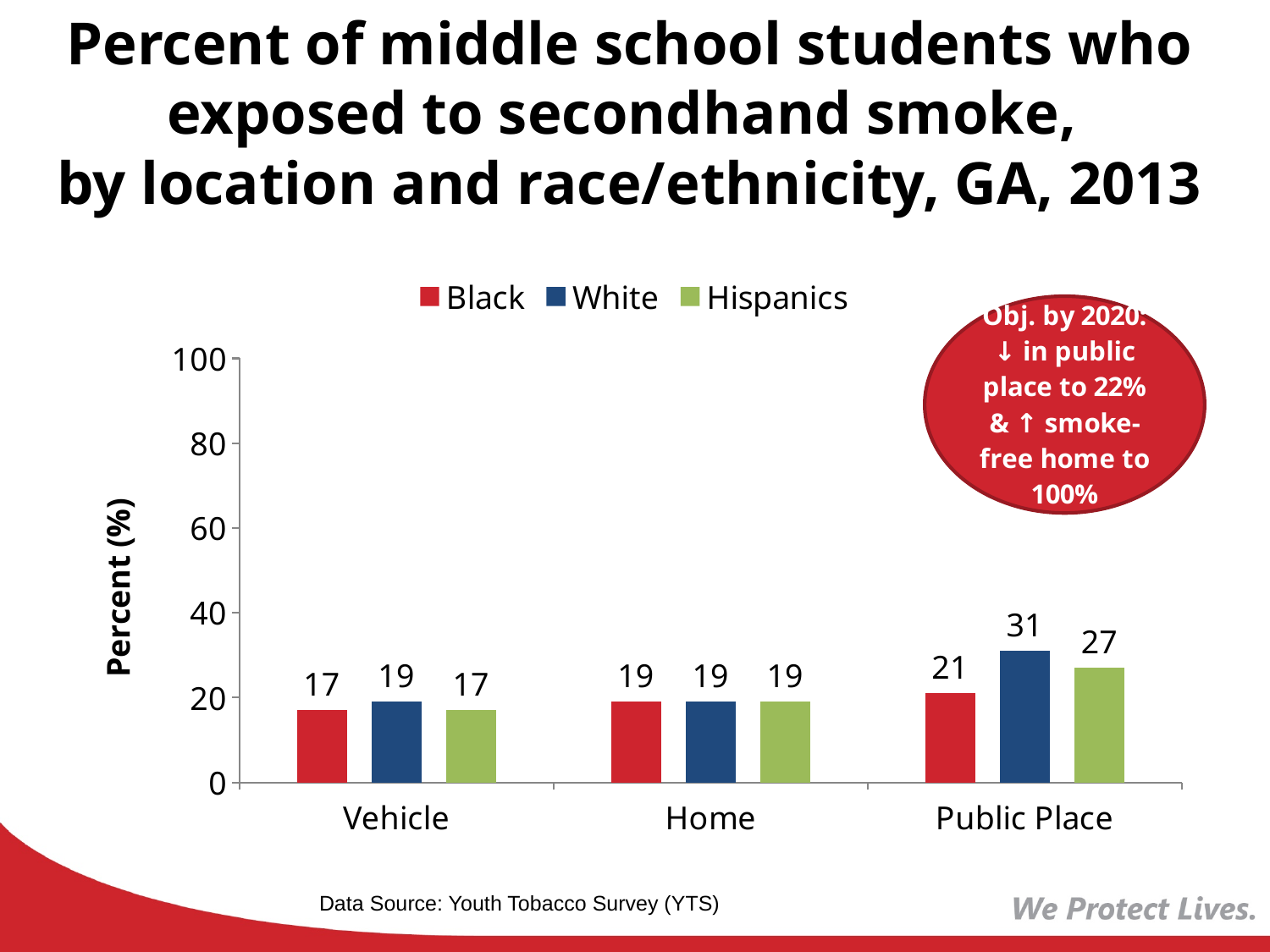
How many location categories are shown on the x axis? 3 What percent of Black middle school students were exposed to secondhand smoke in a vehicle? 17 What kind of chart is shown on the slide? Bar chart What is the difference between the White and Black percentages for Public Place? 10 What percent of White middle school students were exposed to secondhand smoke in a public place? 31 Which race/ethnicity group has the highest percent exposed to secondhand smoke in a public place? White Which is larger: the Hispanics value for Public Place or the Hispanics value for Vehicle? Public Place Which location has the lowest percent of Black students exposed to secondhand smoke? Vehicle Is the value for White students in a public place greater or less than 20? greater Which colour represents the White series in the chart? Blue What percent of Hispanic middle school students were exposed to secondhand smoke at home? 19 How many series does the legend list? 3